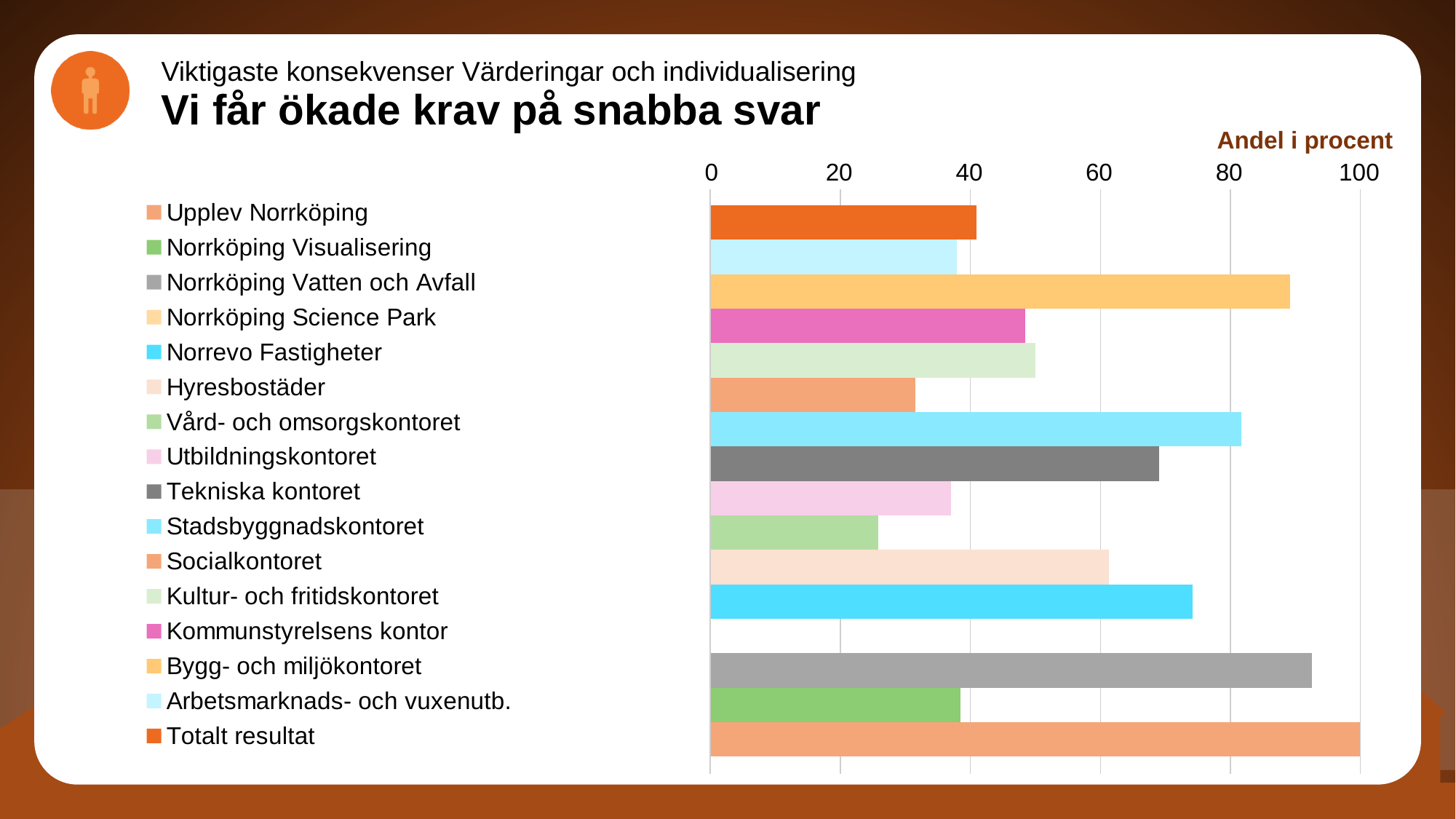
Which has the larger value, Stadsbyggnadskontoret or Tekniska kontoret? Stadsbyggnadskontoret What label is shown above the value axis of the chart? Andel i procent How many categories does the legend of the chart list? 16 Is the value for Socialkontoret greater or less than 40? less Is the value for Totalt resultat greater or less than 60? less Which has the larger value, Hyresbostäder or Socialkontoret? Hyresbostäder What kind of chart is shown on the slide? bar chart What is the value for Upplev Norrköping? 100 Is the value for Bygg- och miljökontoret greater or less than 80? greater Which category has the highest value in the chart? Upplev Norrköping